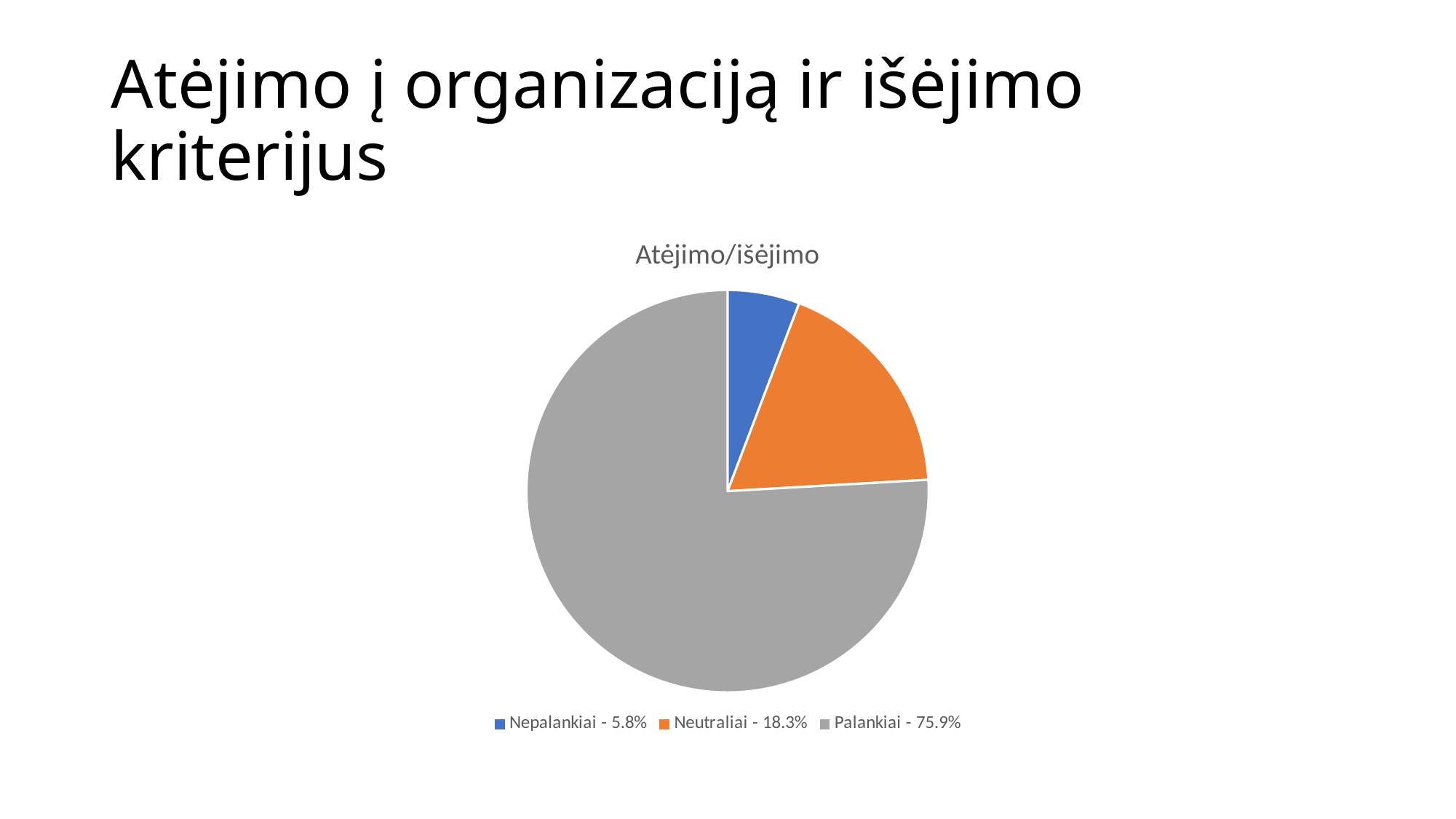
What is the difference in percentage points between the Palankiai and Neutraliai shares? 57.6 What share of the pie does Neutraliai represent? 18.3% Which category has the smallest slice of the pie? Nepalankiai Which category has the largest slice of the pie? Palankiai What is the difference in percentage points between the Neutraliai and Nepalankiai shares? 12.5 What share of the pie does Nepalankiai represent? 5.8% What colour is the Palankiai slice in the pie chart? Grey What kind of chart is shown on the slide? Pie chart What share of the pie does Palankiai represent? 75.9% What is the title of the chart? Atėjimo/išėjimo Which is larger, the share for Neutraliai or the share for Nepalankiai? Neutraliai How many slices does the pie chart have? 3